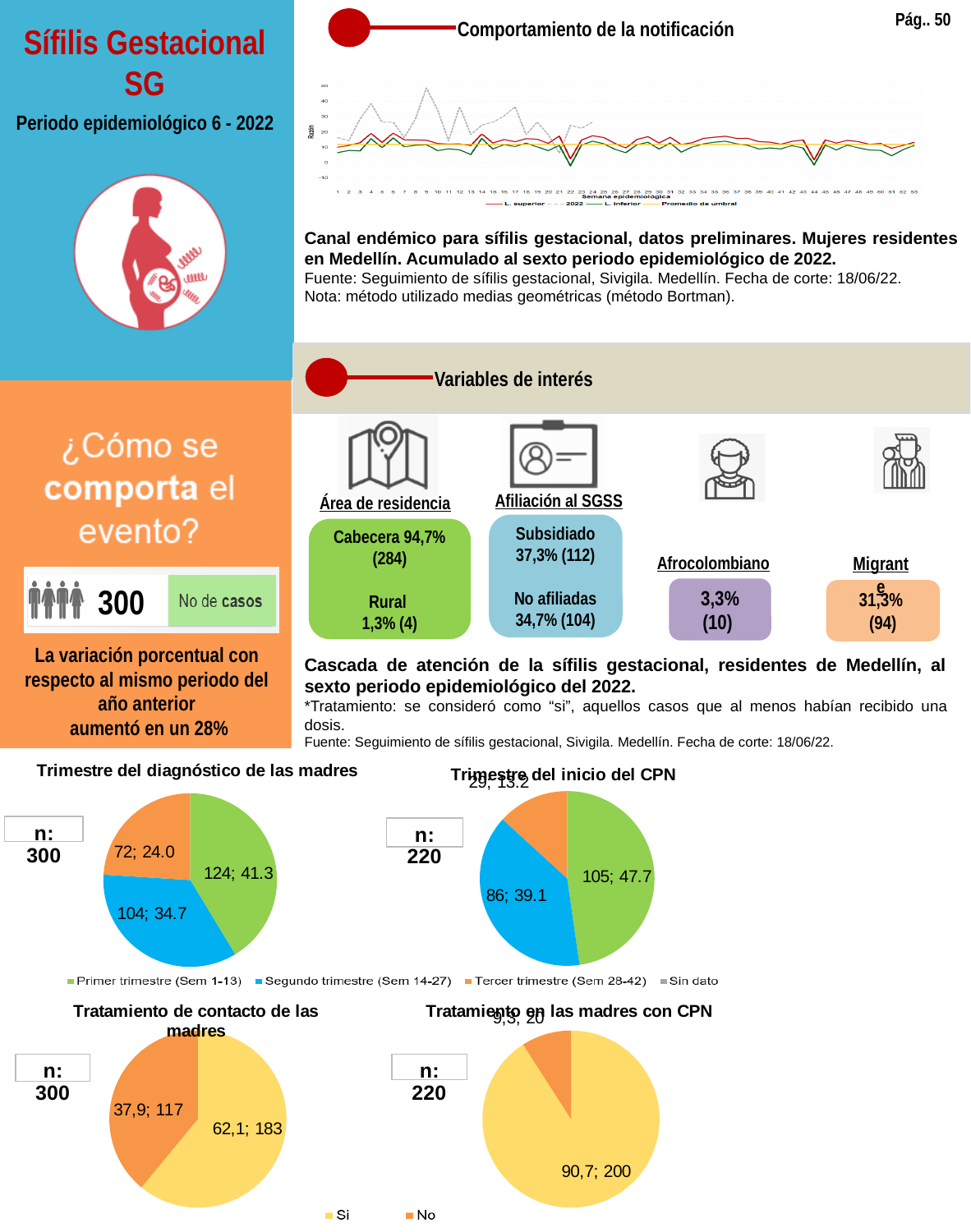
In the pie chart 'Tratamiento de contacto de las madres', what percentage of cases are 'Si'? 62,1 In the pie chart 'Trimestre del diagnóstico de las madres', how many cases correspond to Primer trimestre (Sem 1-13)? 124 How many series does the legend of the line chart 'Comportamiento de la notificación' list? 4 In the pie chart 'Trimestre del inicio del CPN', which trimester has the largest share? Primer trimestre (Sem 1-13) In the pie chart 'Trimestre del diagnóstico de las madres', what percentage share does Segundo trimestre (Sem 14-27) have? 34.7 In the pie chart 'Tratamiento de contacto de las madres', how many cases are 'No'? 117 What type of chart is used for 'Tratamiento de contacto de las madres'? Pie chart In the pie chart 'Trimestre del diagnóstico de las madres', which trimester has the fewest cases? Tercer trimestre (Sem 28-42) In the pie chart 'Tratamiento en las madres con CPN', how many cases are 'Si'? 200 In the pie chart 'Tratamiento en las madres con CPN', which is larger, 'Si' or 'No'? Si In the pie chart 'Trimestre del inicio del CPN', what is the difference in cases between Primer trimestre and Tercer trimestre? 76 In the pie chart 'Trimestre del inicio del CPN', how many cases correspond to Segundo trimestre (Sem 14-27)? 86